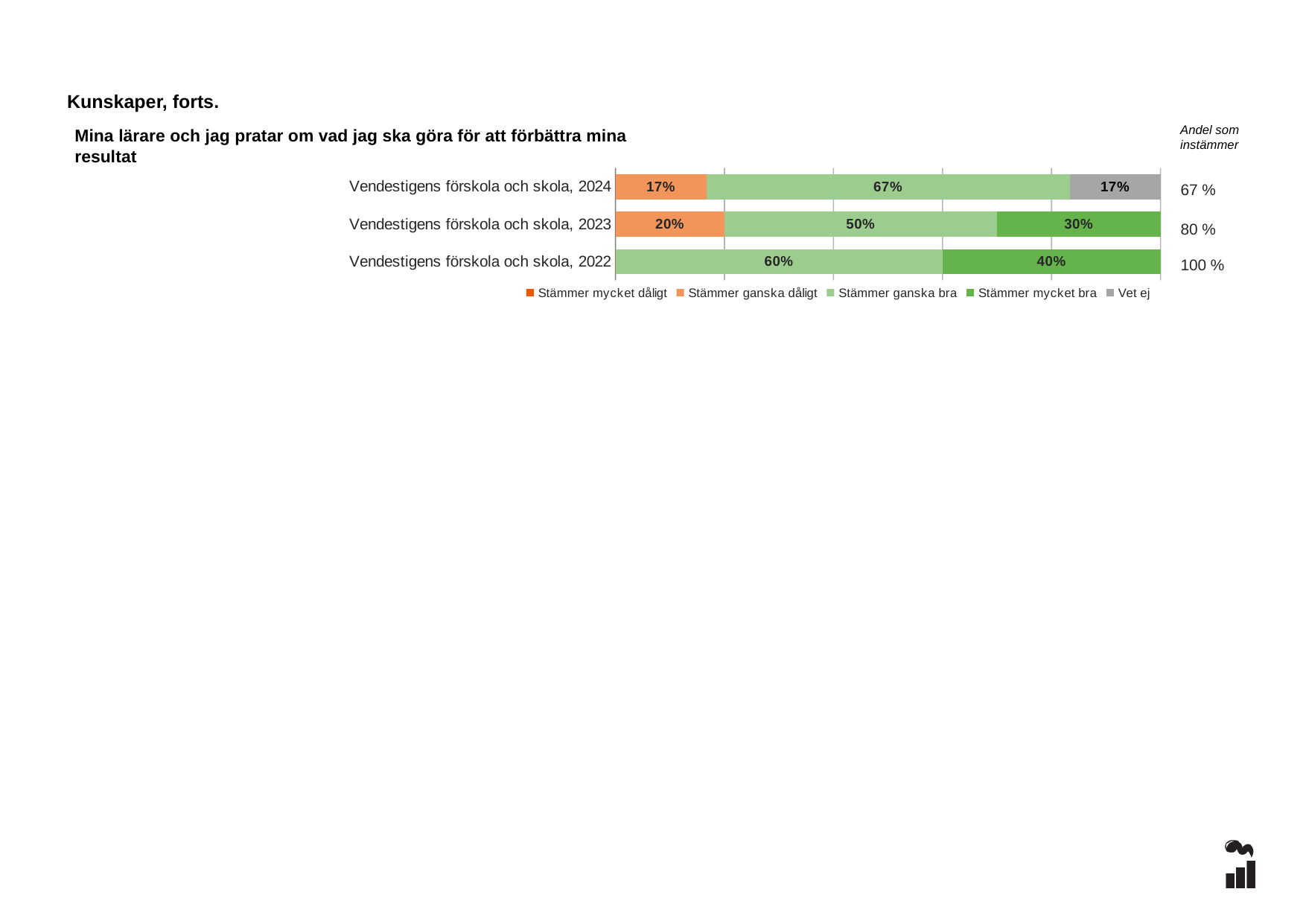
What is the difference between the "Stämmer mycket bra" values for 2022 and 2023? 10% What is the value for "Stämmer ganska dåligt" for Vendestigens förskola och skola, 2023? 20% What is the value for "Stämmer mycket bra" for Vendestigens förskola och skola, 2023? 30% What is the value for "Vet ej" for Vendestigens förskola och skola, 2024? 17% What is the value for "Stämmer ganska bra" for Vendestigens förskola och skola, 2024? 67% Which is larger: "Stämmer ganska dåligt" for 2023 or for 2024? 2023 What kind of chart is shown on the slide? Stacked bar chart Which year has the lowest value for "Stämmer ganska bra"? 2023 How many series does the legend list? 5 What is the "Andel som instämmer" value shown for Vendestigens förskola och skola, 2022? 100 % Which year has the highest value for "Stämmer ganska bra"? 2024 How many bars (categories) are plotted in the chart? 3